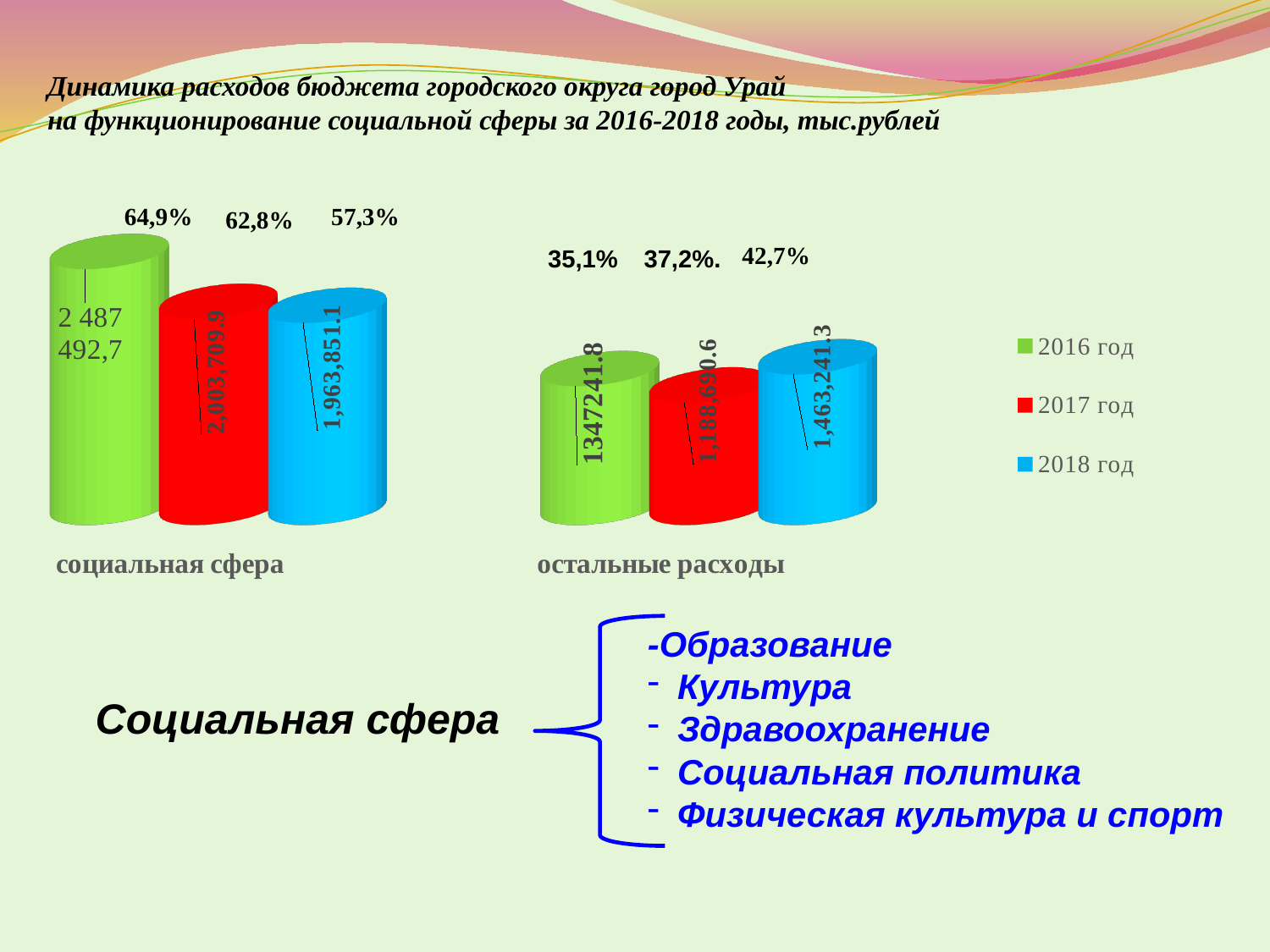
What is the value for 2018 год in the остальные расходы category? 1,463,241.3 What kind of chart is shown on the slide? bar chart Do the values for социальная сфера rise or fall from 2016 год to 2018 год? fall What is the value for 2017 год in the социальная сфера category? 2,003,709.9 How many categories are shown on the x axis of the chart? 2 What is the difference between the 2017 год and 2018 год values in the социальная сфера category? 39,858.8 Which year has the lowest value in the остальные расходы category? 2017 год What is the value for 2016 год in the социальная сфера category? 2 487 492,7 What is the value for 2017 год in the остальные расходы category? 1,188,690.6 Which year has the highest value in the социальная сфера category? 2016 год How many series does the legend list? 3 Which is larger in the остальные расходы category: the value for 2016 год or for 2018 год? 2018 год